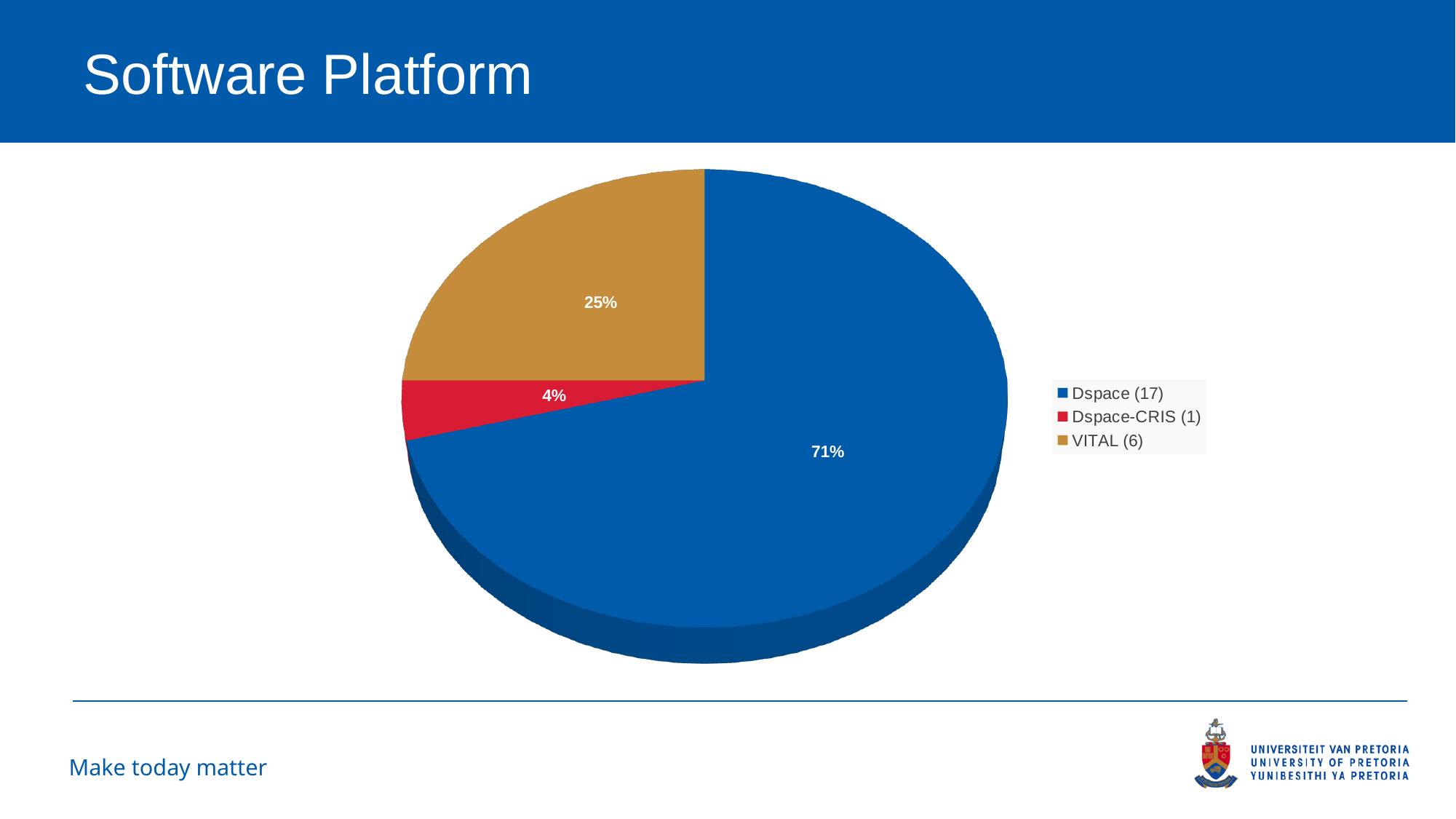
What colour is the Dspace-CRIS slice? red What percentage share does Dspace have in the pie chart? 71% How many entries does the legend list? 3 What kind of chart is shown on the slide? pie chart What percentage share does Dspace-CRIS have in the pie chart? 4% What percentage share does VITAL have in the pie chart? 25% How many slices does the pie chart have? 3 Which software platform has the smallest slice of the pie? Dspace-CRIS What is the difference in percentage points between the Dspace slice and the VITAL slice? 46 What count is shown in the legend next to VITAL? 6 Which slice is larger, VITAL or Dspace-CRIS? VITAL Which software platform has the largest slice of the pie? Dspace